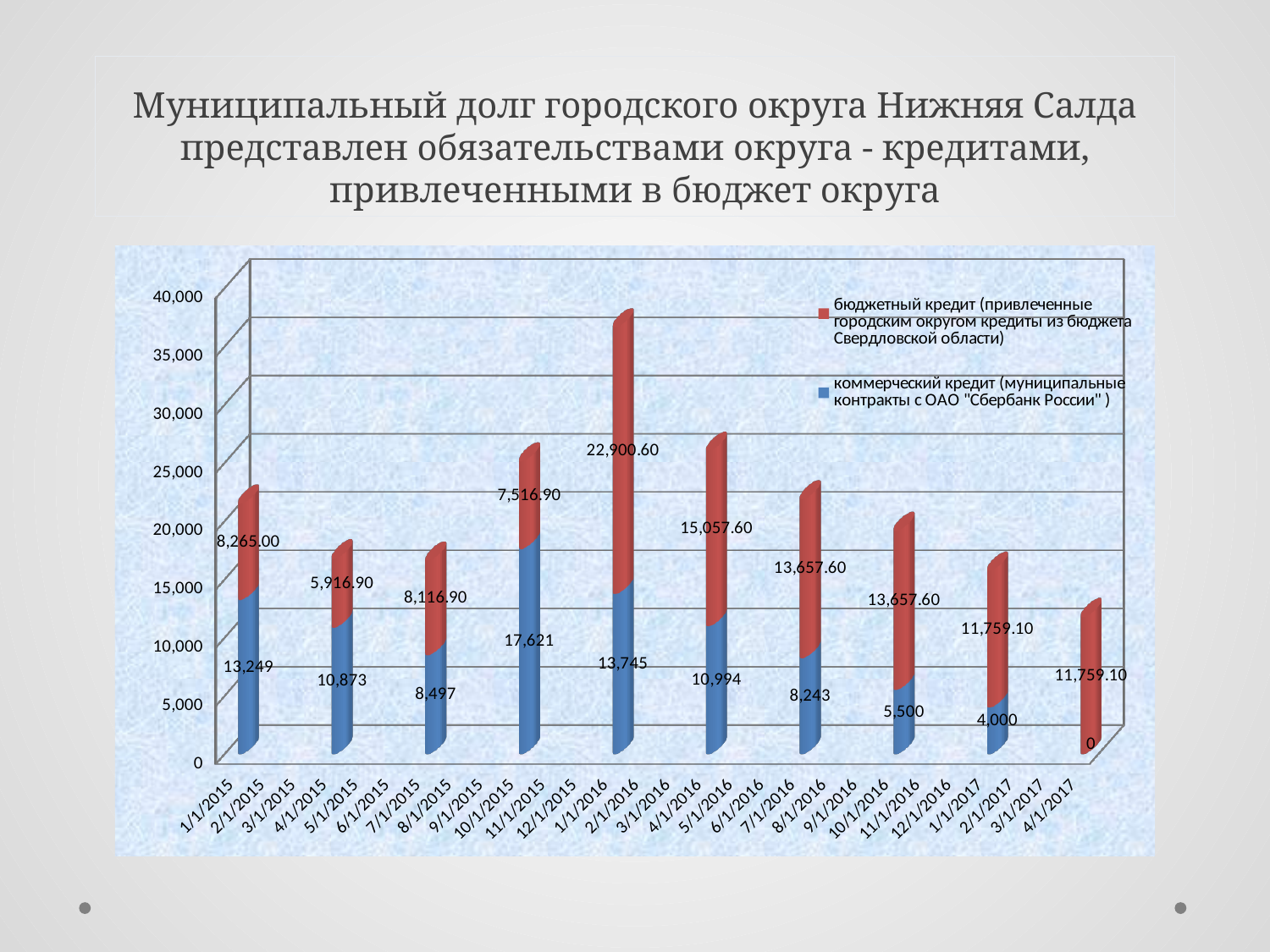
What is the value of the commercial credit series for the last bar, at 4/1/2017? 0 At which date is the budget credit (бюджетный кредит) value lowest? 4/1/2015 Which is larger: the commercial credit value at 1/1/2015 or at 4/1/2015? 1/1/2015 At which date is the commercial credit (коммерческий кредит) value highest? 10/1/2015 What is the total of the stacked bar at 1/1/2016? 36,645.60 What is the value of the commercial credit (коммерческий кредит) series for the first bar, at 1/1/2015? 13,249 How many stacked bars are plotted in the chart? 10 What kind of chart is shown on the slide? bar chart How many series does the legend list? 2 What is the difference between the budget credit values at 1/1/2016 (22,900.60) and 4/1/2016 (15,057.60)? 7,843.00 What is the value of the budget credit (бюджетный кредит) series for the bar at 1/1/2016? 22,900.60 At which date is the budget credit (бюджетный кредит) value highest? 1/1/2016